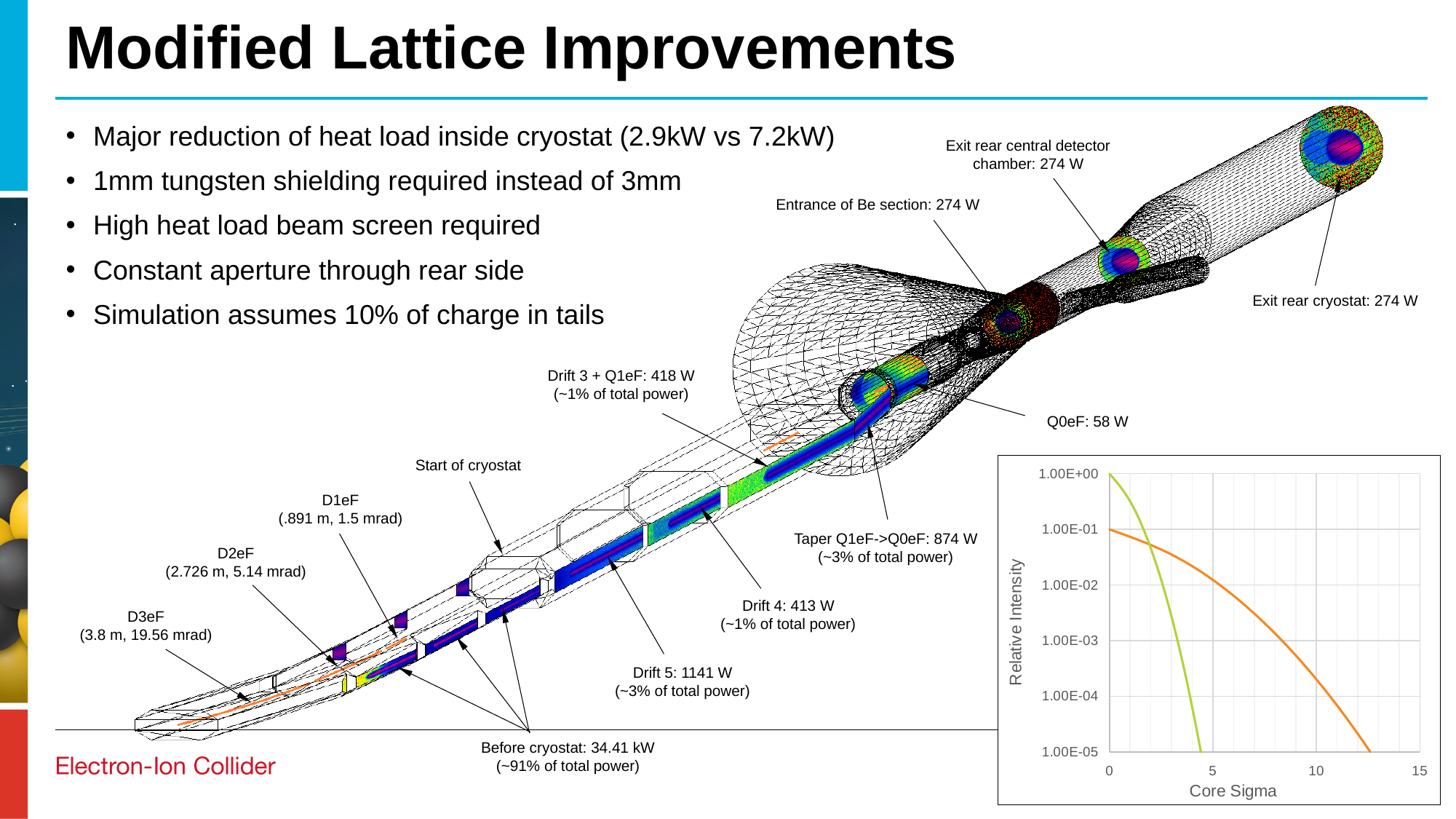
What kind of chart is shown in the bottom-right corner of the slide? line chart How many lines are plotted in the bottom-right chart? 2 In the bottom-right chart, do the lines rise or fall as Core Sigma increases? fall In the bottom-right chart, what is the highest value shown on the y axis? 1.00E+00 In the bottom-right chart, is the orange line's value at Core Sigma 5 greater or less than 1.00E-04? greater In the bottom-right chart, is the orange line's value at Core Sigma 10 greater or less than 1.00E-03? less In the bottom-right chart, what is the label of the y axis? Relative Intensity In the bottom-right chart, which line reaches 1.00E-05 at the smaller Core Sigma, the green line or the orange line? green line In the bottom-right chart, which line is higher at Core Sigma 5, the green line or the orange line? orange line In the bottom-right chart, what is the label of the x axis? Core Sigma In the bottom-right chart, which line is higher at Core Sigma 0, the green line or the orange line? green line In the bottom-right chart, is the green line's value at Core Sigma 4 greater or less than 1.00E-03? less